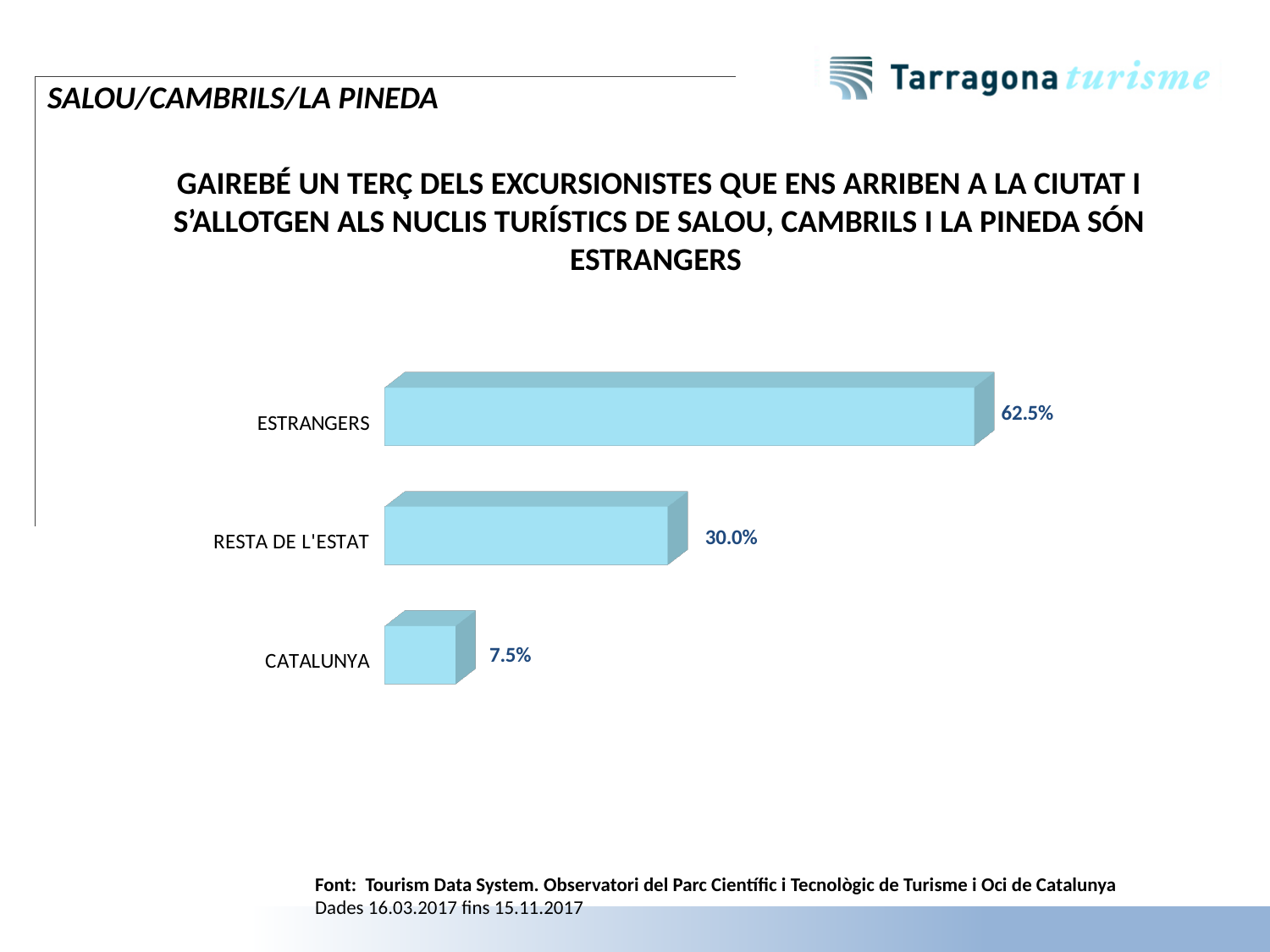
What is the value for CATALUNYA? 7.5% What is the source cited below the chart? Tourism Data System. Observatori del Parc Científic i Tecnològic de Turisme i Oci de Catalunya What is the value for ESTRANGERS? 62.5% Which category has the highest value? ESTRANGERS How many categories are shown in the chart? 3 Which is larger, the value for RESTA DE L'ESTAT or the value for CATALUNYA? RESTA DE L'ESTAT What is the difference between the values for RESTA DE L'ESTAT and CATALUNYA? 22.5% Which category has the lowest value? CATALUNYA What kind of chart is shown on the slide? Bar chart What is the value for RESTA DE L'ESTAT? 30.0% What is the total of the three values shown in the chart? 100.0% What is the difference between the values for ESTRANGERS and RESTA DE L'ESTAT? 32.5%